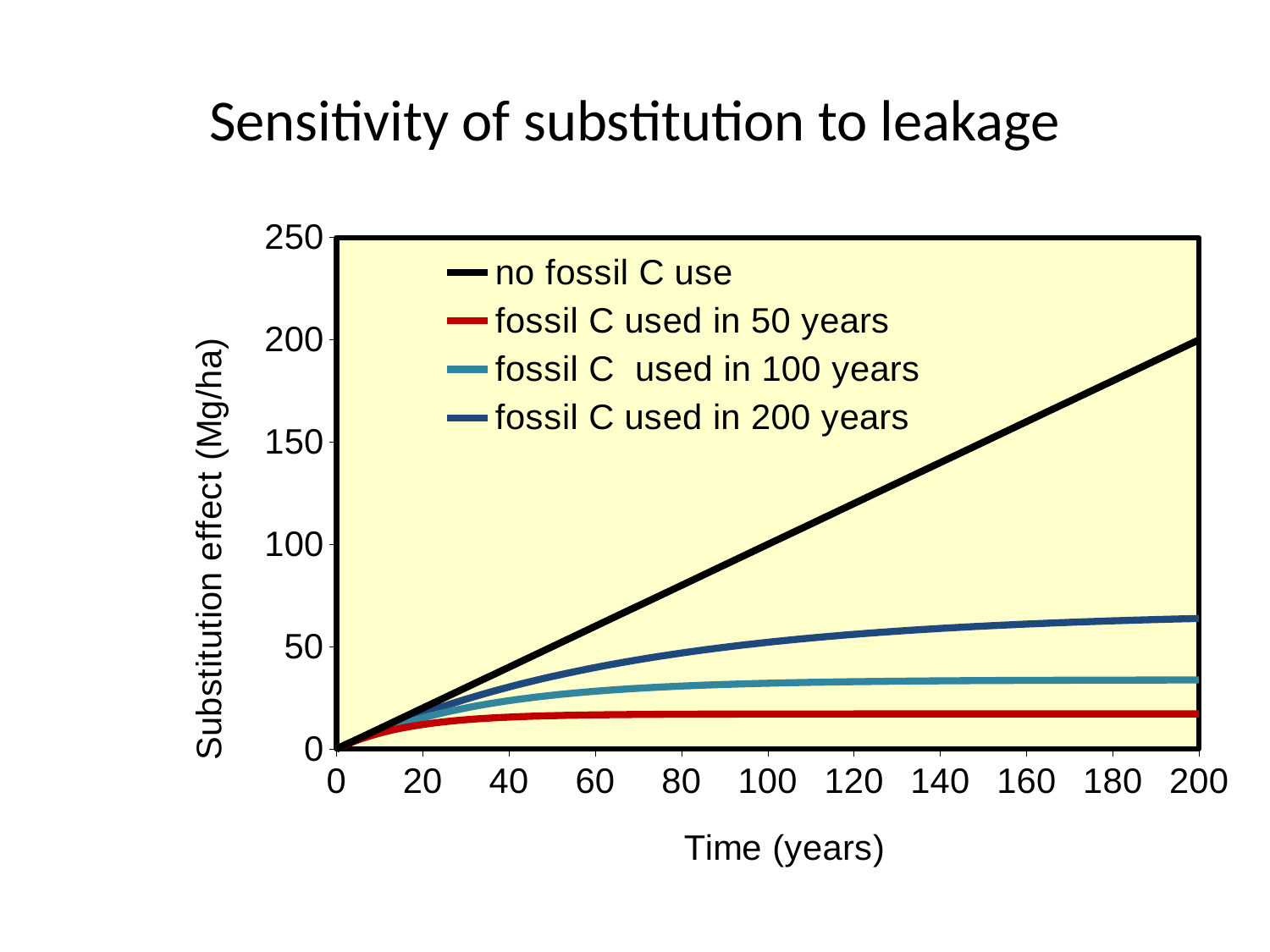
What is the label of the y axis? Substitution effect (Mg/ha) Is the value for fossil C used in 200 years at 200 years greater or less than 50? greater Is the value for fossil C used in 100 years at 200 years greater or less than 50? less Is the value for no fossil C use at 100 years greater or less than 150? less At 200 years, which is larger: the value for fossil C used in 100 years or fossil C used in 200 years? fossil C used in 200 years Which series has the lowest substitution effect at 200 years? fossil C used in 50 years What is the title of the chart? Sensitivity of substitution to leakage Does the no fossil C use series rise or fall as time increases? rise How many series does the legend list? 4 Which series has the highest substitution effect at 200 years? no fossil C use What kind of chart is shown on the slide? line chart